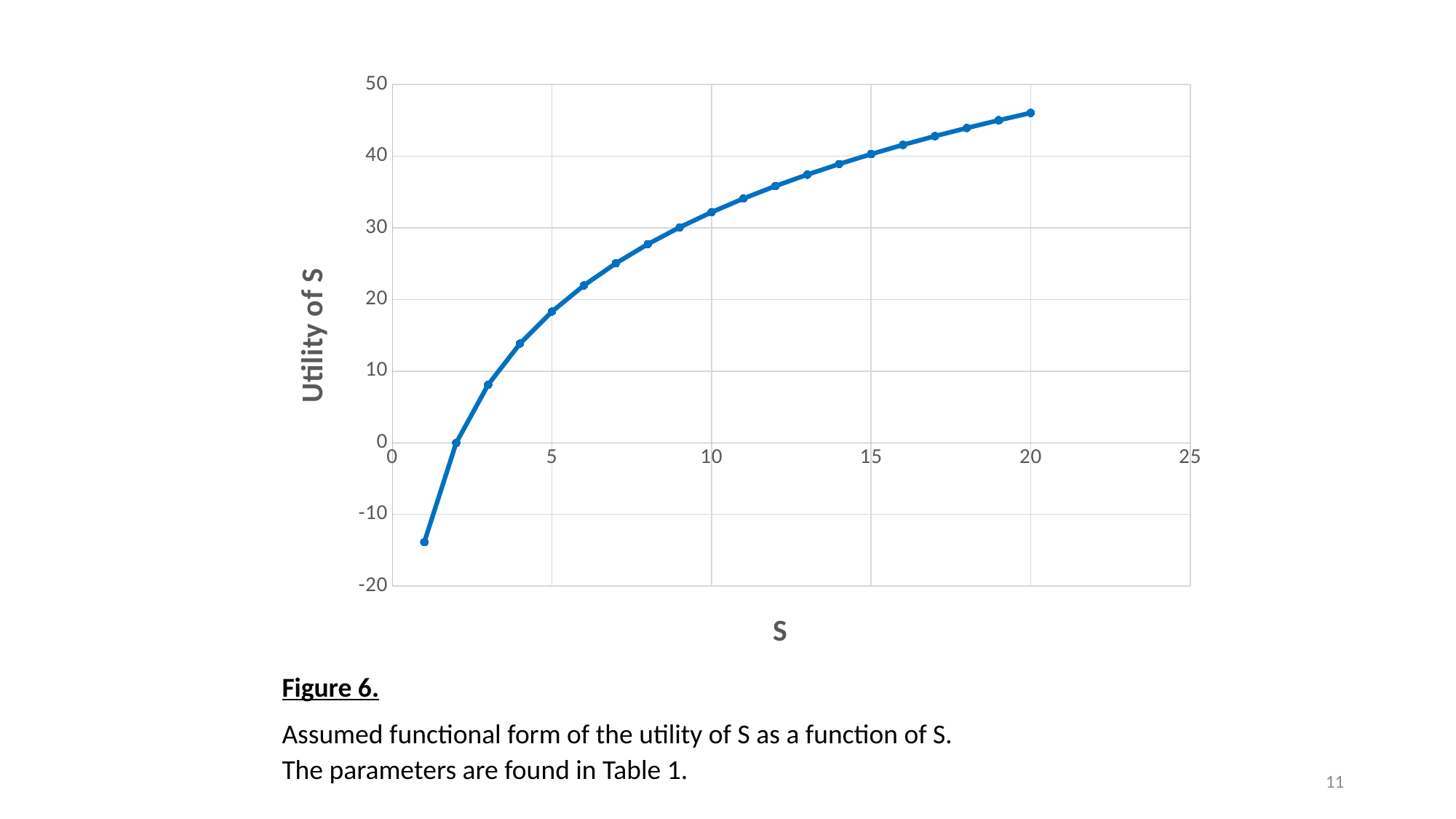
What is the label on the vertical axis of the chart? Utility of S What is the utility of S when S is 2? 0 At which value of S is the utility of S lowest? 1 At which value of S is the utility of S highest? 20 Is the utility of S at S = 10 greater or less than 30? greater What kind of chart is shown on the slide? line chart Which has the larger utility of S: S = 5 or S = 15? S = 15 Does the utility of S rise or fall as S increases along the x axis? rise Is the utility of S at S = 1 greater or less than -10? less How many data points are plotted on the line? 20 Is the utility of S at S = 20 greater or less than 40? greater